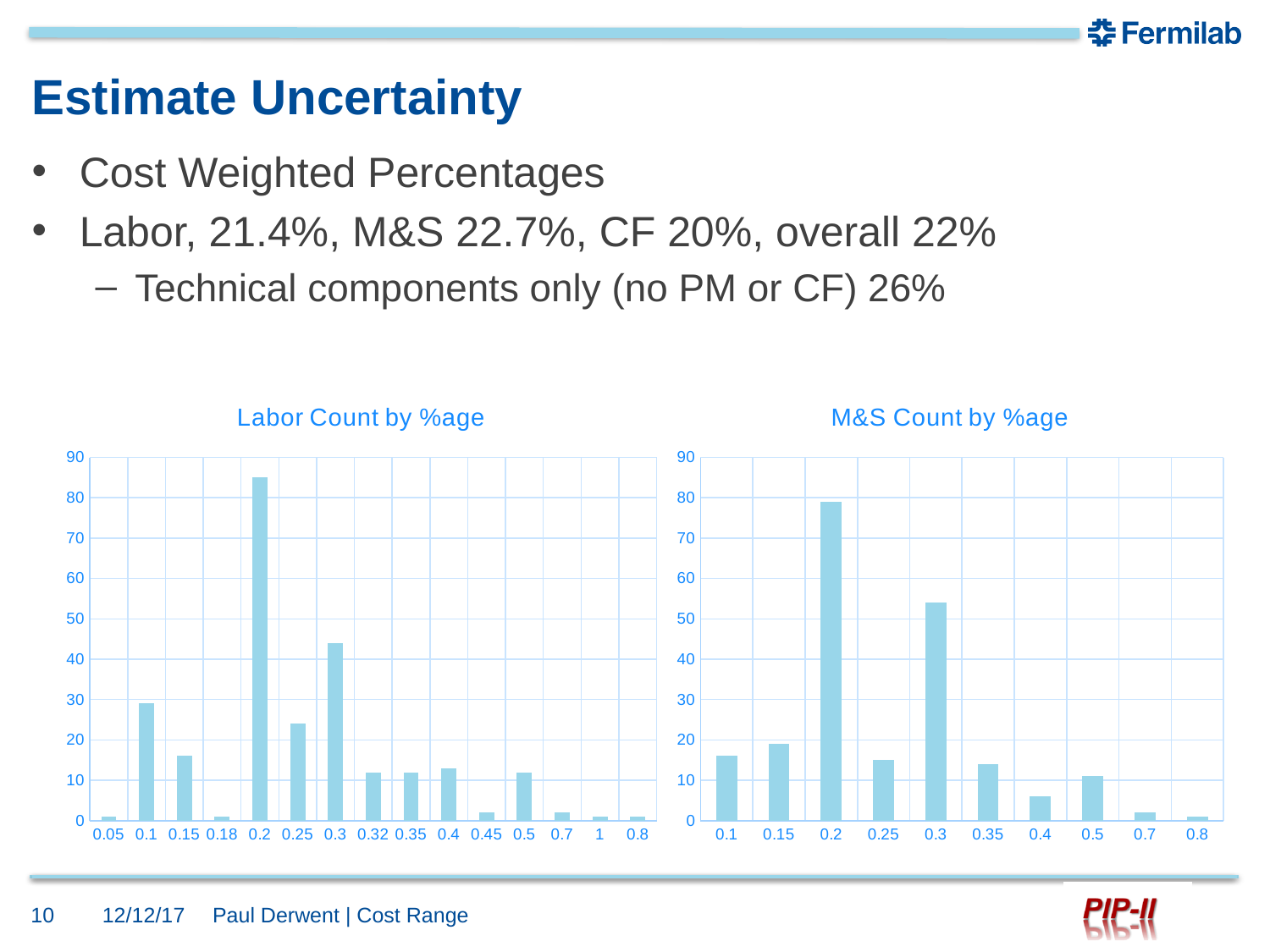
In the M&S Count by %age chart, is the value for 0.3 greater or less than 50? greater In the Labor Count by %age chart, is the value for 0.3 greater or less than 40? greater In the M&S Count by %age chart, is the value for 0.1 greater or less than 10? greater How many categories are shown on the x axis of the M&S Count by %age chart? 10 What kind of chart is the M&S Count by %age chart? Bar chart In the Labor Count by %age chart, which is larger, the value for 0.25 or the value for 0.3? 0.3 In the Labor Count by %age chart, which category has the highest bar? 0.2 In the M&S Count by %age chart, which category has the highest bar? 0.2 How many categories are shown on the x axis of the Labor Count by %age chart? 15 In the M&S Count by %age chart, which is larger, the value for 0.2 or the value for 0.3? 0.2